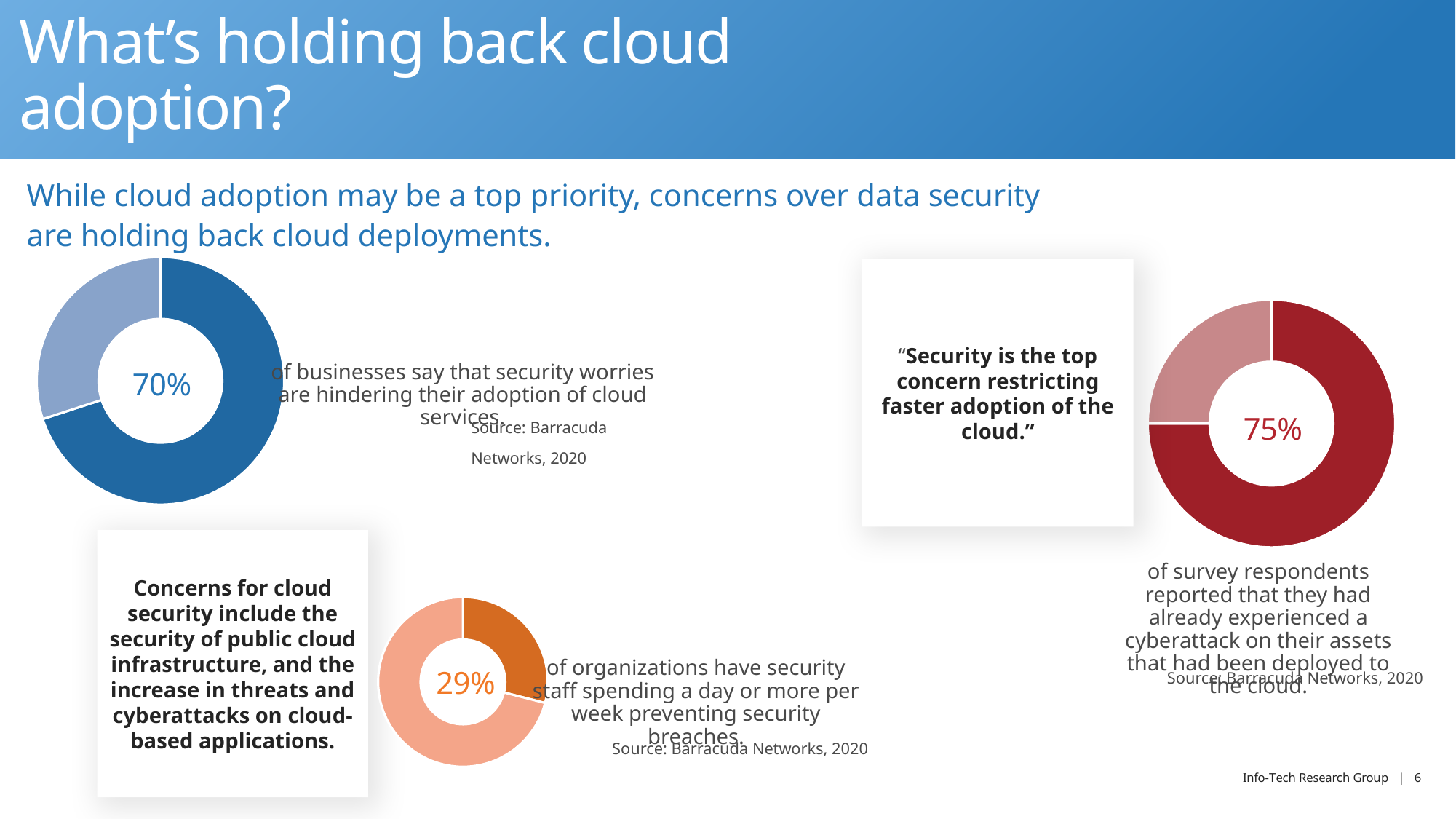
In the orange donut chart at the bottom of the slide, what share of the ring does the darker orange slice represent? 29% Which of the three donut charts on the slide shows the highest percentage? The red chart on the right (75%) Which of the three donut charts on the slide shows the lowest percentage? The orange chart at the bottom (29%) What percentage is shown in the centre of the blue donut chart at the top left of the slide? 70% How many donut charts are on the slide? 3 Is the percentage in the red donut chart on the right larger or smaller than the percentage in the blue donut chart at the top left? Larger What colour is the donut chart that shows 75%? Red What percentage is shown in the centre of the red donut chart on the right of the slide? 75% What kind of chart is used to show the 70% figure at the top left of the slide? Donut chart What percentage is shown in the centre of the orange donut chart at the bottom of the slide? 29% What is the difference in percentage points between the red donut chart (75%) and the blue donut chart (70%)? 5 percentage points What is the difference in percentage points between the red donut chart (75%) and the orange donut chart (29%)? 46 percentage points